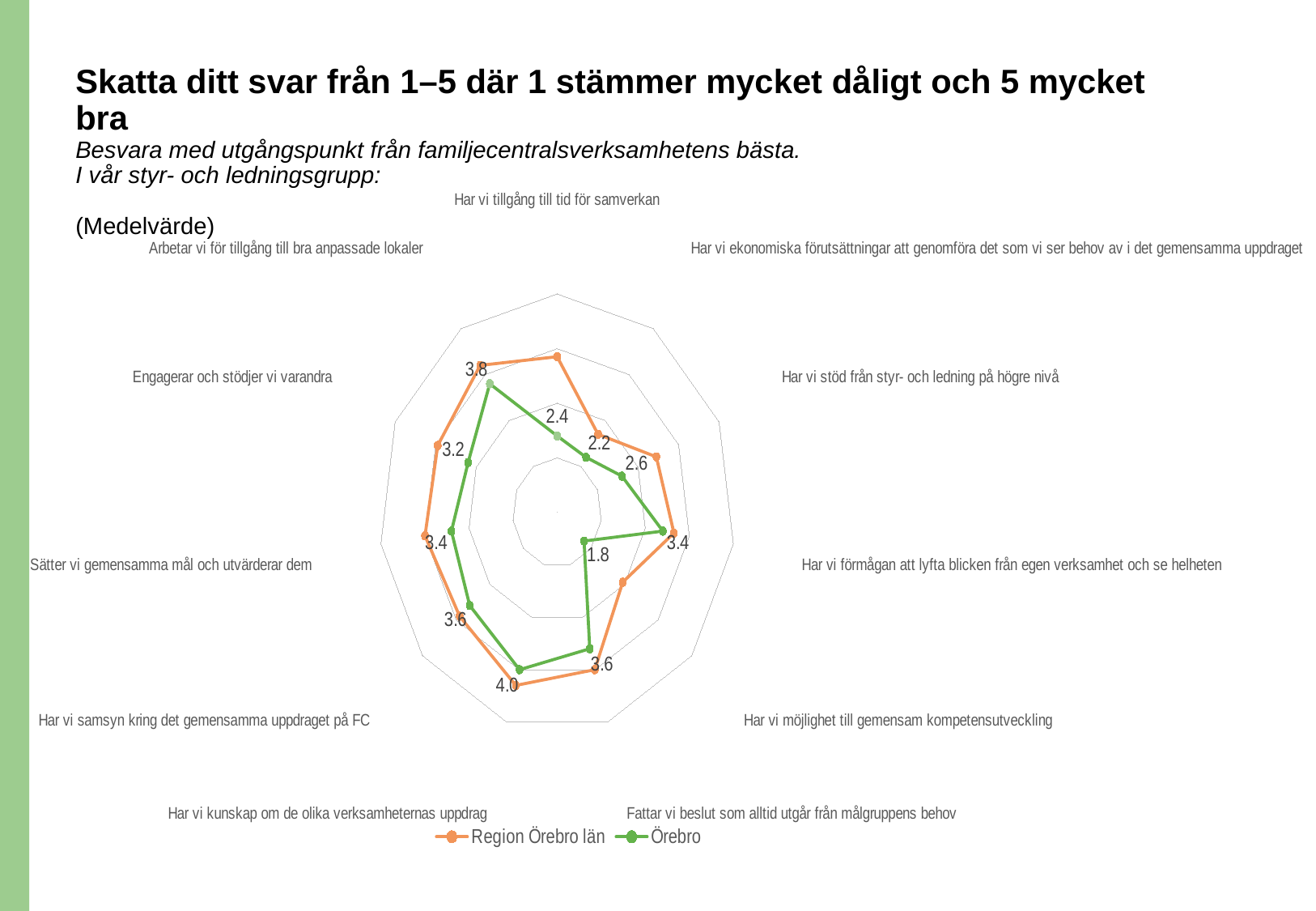
What is the value for Örebro on "Har vi möjlighet till gemensam kompetensutveckling"? 1.8 How many categories (axes) does the radar chart have? 11 For Örebro, which is higher: "Har vi stöd från styr- och ledning på högre nivå" or "Har vi tillgång till tid för samverkan"? Har vi stöd från styr- och ledning på högre nivå What is the value for Örebro on "Har vi kunskap om de olika verksamheternas uppdrag"? 4.0 What is the value for Örebro on "Engagerar och stödjer vi varandra"? 3.2 What is the difference between Örebro's highest value (4.0) and its lowest value (1.8)? 2.2 What kind of chart is shown on the slide? Radar chart How many series does the legend list? 2 Which series has the higher value on "Har vi möjlighet till gemensam kompetensutveckling"? Region Örebro län On which category does Örebro have its highest value? Har vi kunskap om de olika verksamheternas uppdrag What is the value for Örebro on "Sätter vi gemensamma mål och utvärderar dem"? 3.4 On which category does Örebro have its lowest value? Har vi möjlighet till gemensam kompetensutveckling